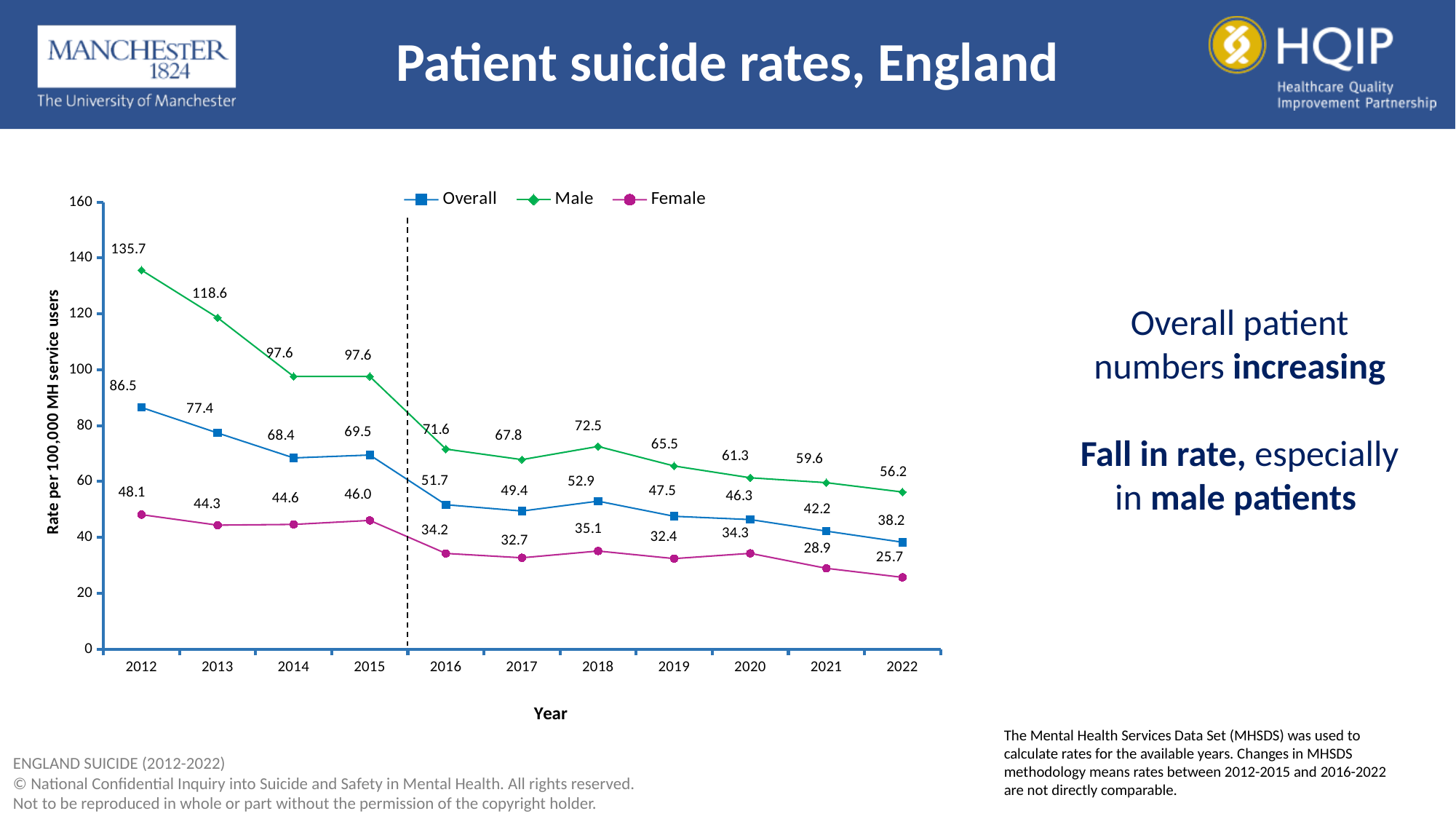
Does the Male rate generally rise or fall from 2012 to 2022? fall What is the Female rate in 2018? 35.1 In which year is the Male rate highest? 2012 What kind of chart is shown on the slide? line chart In which year is the Female rate lowest? 2022 Which year has the higher Male rate, 2017 or 2018? 2018 What is the Overall rate in 2022? 38.2 How many years are shown on the x axis? 11 What is the difference between the Male rate in 2012 and the Male rate in 2022? 79.5 What is the Male rate in 2012? 135.7 Is the Overall rate in 2012 greater or less than 80? greater How many series does the legend list? 3